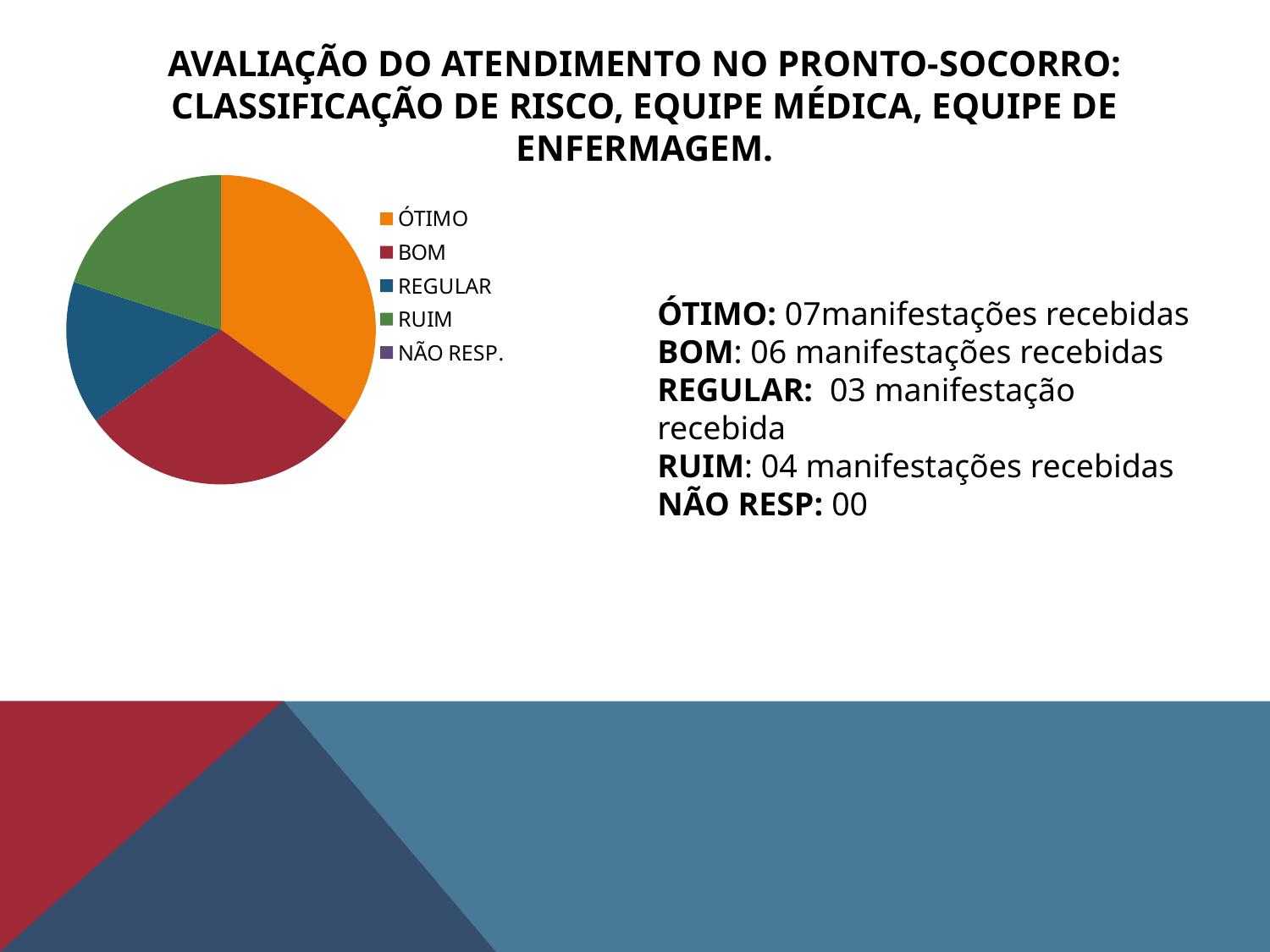
What value is reported for NÃO RESP? 00 Which category has the largest slice of the pie chart? ÓTIMO What is the difference between the number of manifestações for ÓTIMO and for REGULAR? 4 How many entries does the legend of the pie chart list? 5 How many manifestações are reported for REGULAR? 03 Which is larger, the value for BOM or the value for RUIM? BOM What kind of chart is shown on the slide? Pie chart Which category with a visible slice has the smallest share of the pie chart? REGULAR How many manifestações recebidas are reported for RUIM? 04 How many manifestações recebidas are reported for ÓTIMO? 07 How many manifestações recebidas are reported for BOM? 06 What colour is the slice for ÓTIMO in the pie chart? Orange